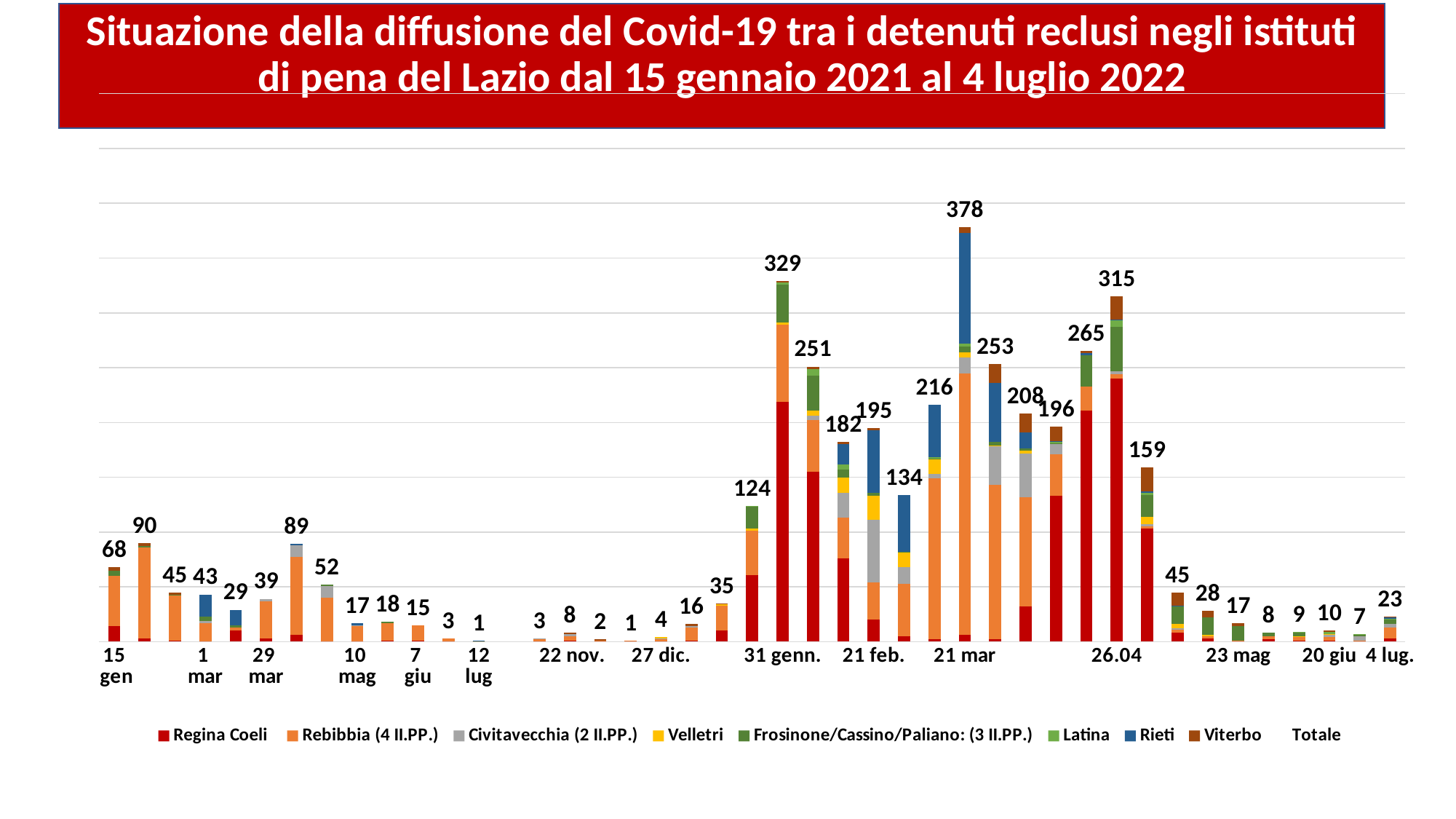
What is the total value shown for 21 feb.? 195 What is the total value shown for 31 genn.? 329 What is the total value shown for 4 lug.? 23 Which date has the highest total value? 21 mar What kind of chart is shown on the slide? Stacked bar chart Which has a larger total, 31 genn. or 26.04? 31 genn. What is the difference between the totals for 21 mar and 31 genn.? 49 What is the total value shown for 26.04? 315 Which series is listed first in the legend? Regina Coeli What is the total value shown for 15 gen? 68 What is the total value shown for 21 mar? 378 How many entries does the legend list? 9